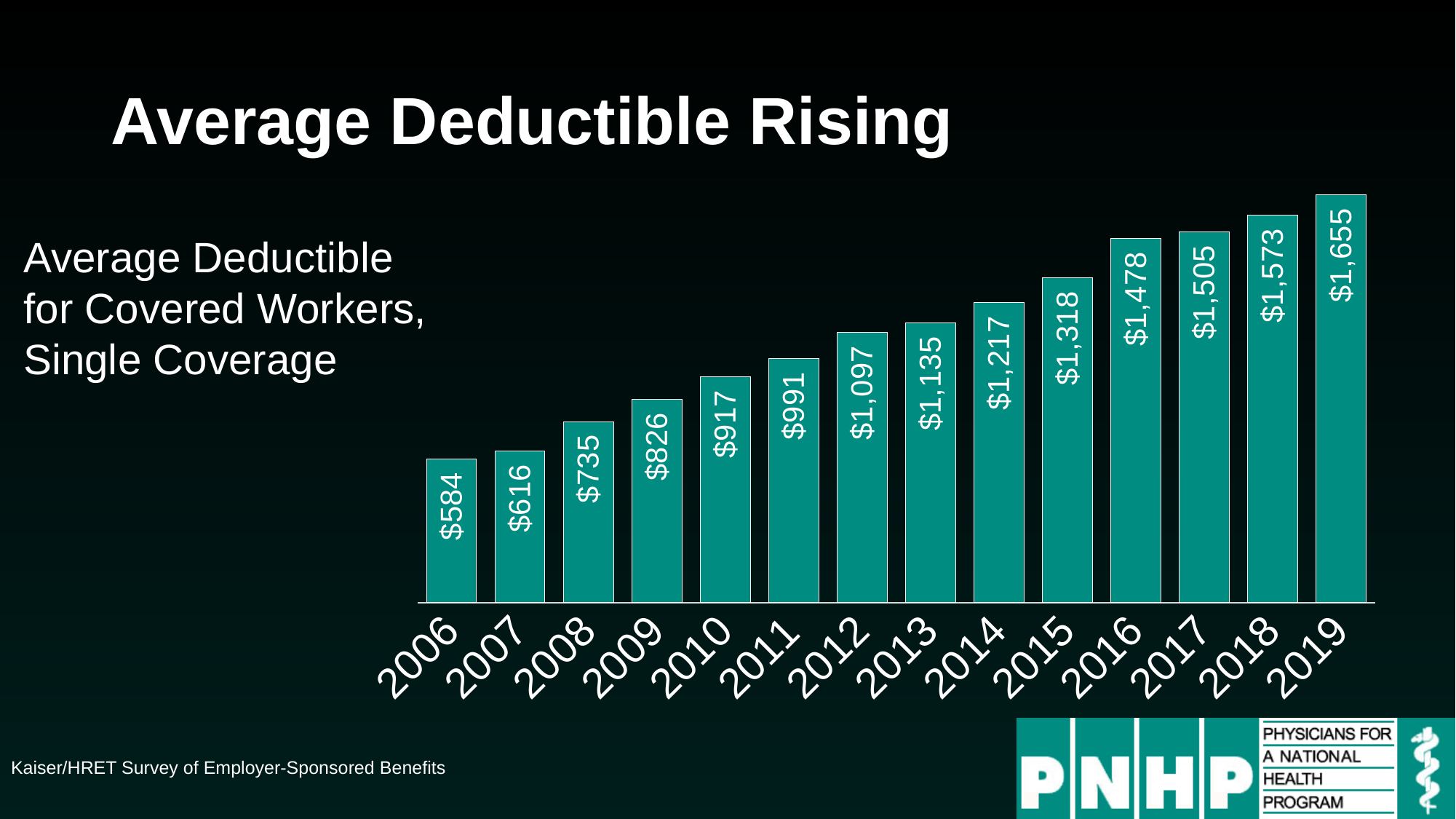
What is the difference between the average deductible in 2016 and in 2015? $160 What is the average deductible shown for 2013? $1,135 Which year has the highest average deductible? 2019 Do the average deductible values rise or fall from 2006 to 2019? Rise What kind of chart is shown on the slide? Bar chart What is the source cited for the chart data? Kaiser/HRET Survey of Employer-Sponsored Benefits Which year has the lowest average deductible? 2006 What is the average deductible shown for 2019? $1,655 How many years are shown on the chart? 14 What is the difference between the average deductible in 2019 and in 2006? $1,071 What is the average deductible shown for 2006? $584 Which year has a larger average deductible, 2010 or 2012? 2012